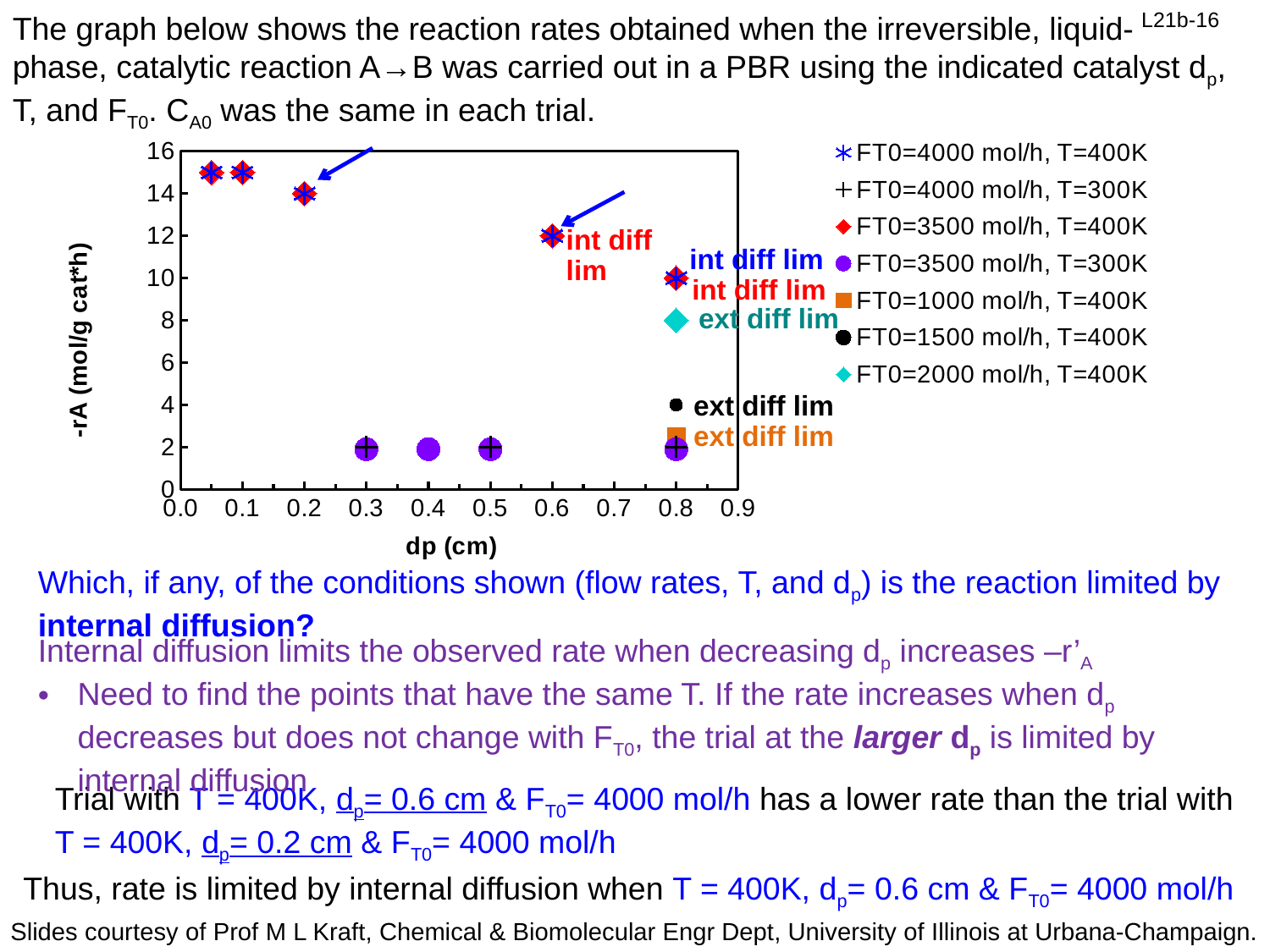
What is the title of the x axis of the chart? dp (cm) What is the value of -rA for the FT0=4000 mol/h, T=400K series at dp = 0.6 cm? 12 How many series does the chart legend list? 7 What is the value of -rA for the FT0=4000 mol/h, T=400K series at dp = 0.2 cm? 14 Is the value of -rA for the FT0=4000 mol/h, T=400K series at dp = 0.1 cm greater or less than 14? greater What is the title of the y axis of the chart? -rA (mol/g cat*h) Is the value of -rA for the FT0=1000 mol/h, T=400K series at dp = 0.8 cm greater or less than 4? less What is the value of -rA for the FT0=2000 mol/h, T=400K series at dp = 0.8 cm? 8 What kind of chart is shown on the slide? scatter chart At dp = 0.8 cm, which has the larger -rA: the FT0=3500 mol/h, T=400K series or the FT0=2000 mol/h, T=400K series? FT0=3500 mol/h, T=400K What is the value of -rA for the FT0=1500 mol/h, T=400K series at dp = 0.8 cm? 4